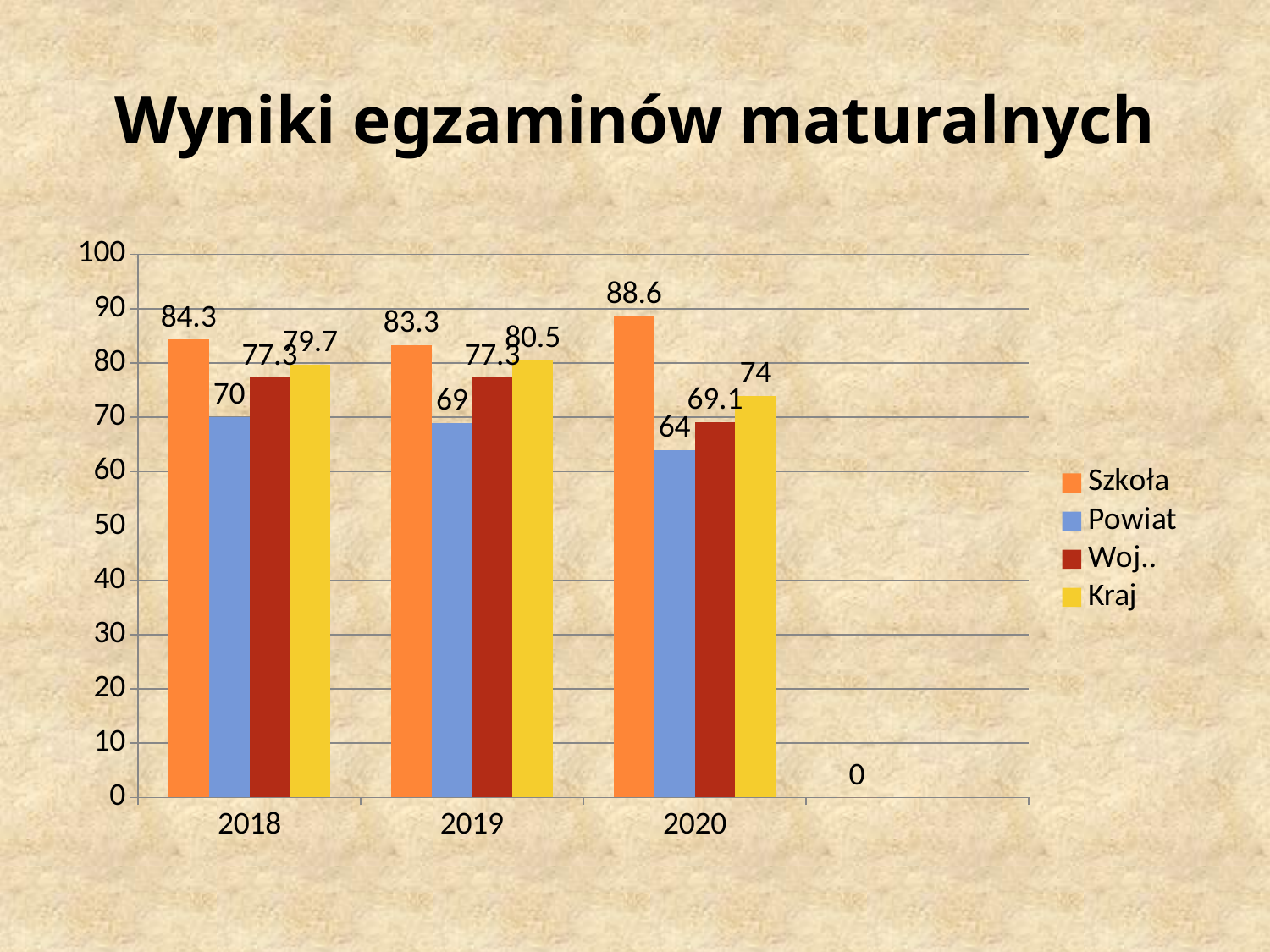
Do the Powiat values rise or fall from 2018 to 2020? Fall What is the title of the slide? Wyniki egzaminów maturalnych What is the difference between the Szkoła and Powiat values in 2020? 24.6 How many series does the legend list? 4 What is the value for Szkoła in 2020? 88.6 What kind of chart is shown on the slide? Bar chart In which year is the Szkoła value highest? 2020 What is the value for Powiat in 2018? 70 Which is larger in 2018, the Kraj value or the Woj.. value? Kraj In which year is the Powiat value lowest? 2020 What is the value for Kraj in 2019? 80.5 What is the value for Woj.. in 2020? 69.1